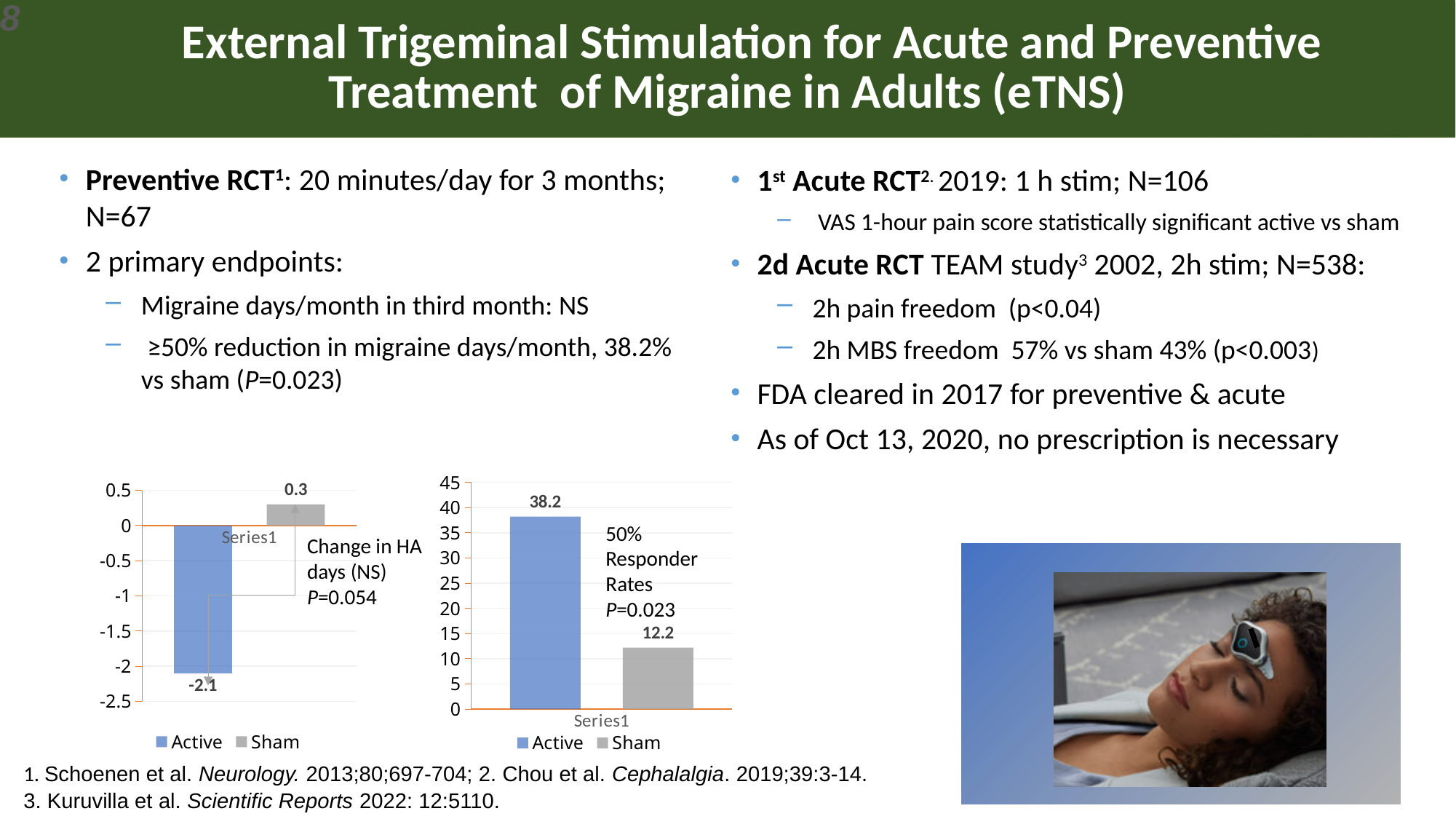
In the left chart (Change in HA days), which series has the lower value? Active In the right chart (50% Responder Rates), what is the value for Sham? 12.2 In the right chart (50% Responder Rates), is the value for Active greater or less than 35? greater In the right chart (50% Responder Rates), which series has the higher value? Active How many series does the legend of the right chart (50% Responder Rates) list? 2 What P value is shown next to the right chart (50% Responder Rates)? P=0.023 In the left chart (Change in HA days), what is the value for Active? -2.1 In the right chart (50% Responder Rates), what is the value for Active? 38.2 In the right chart (50% Responder Rates), what is the difference between the Active and Sham values? 26 In the left chart (Change in HA days), what is the difference between the Sham and Active values? 2.4 What kind of chart is the left chart (Change in HA days)? Bar chart In the left chart (Change in HA days), what is the value for Sham? 0.3